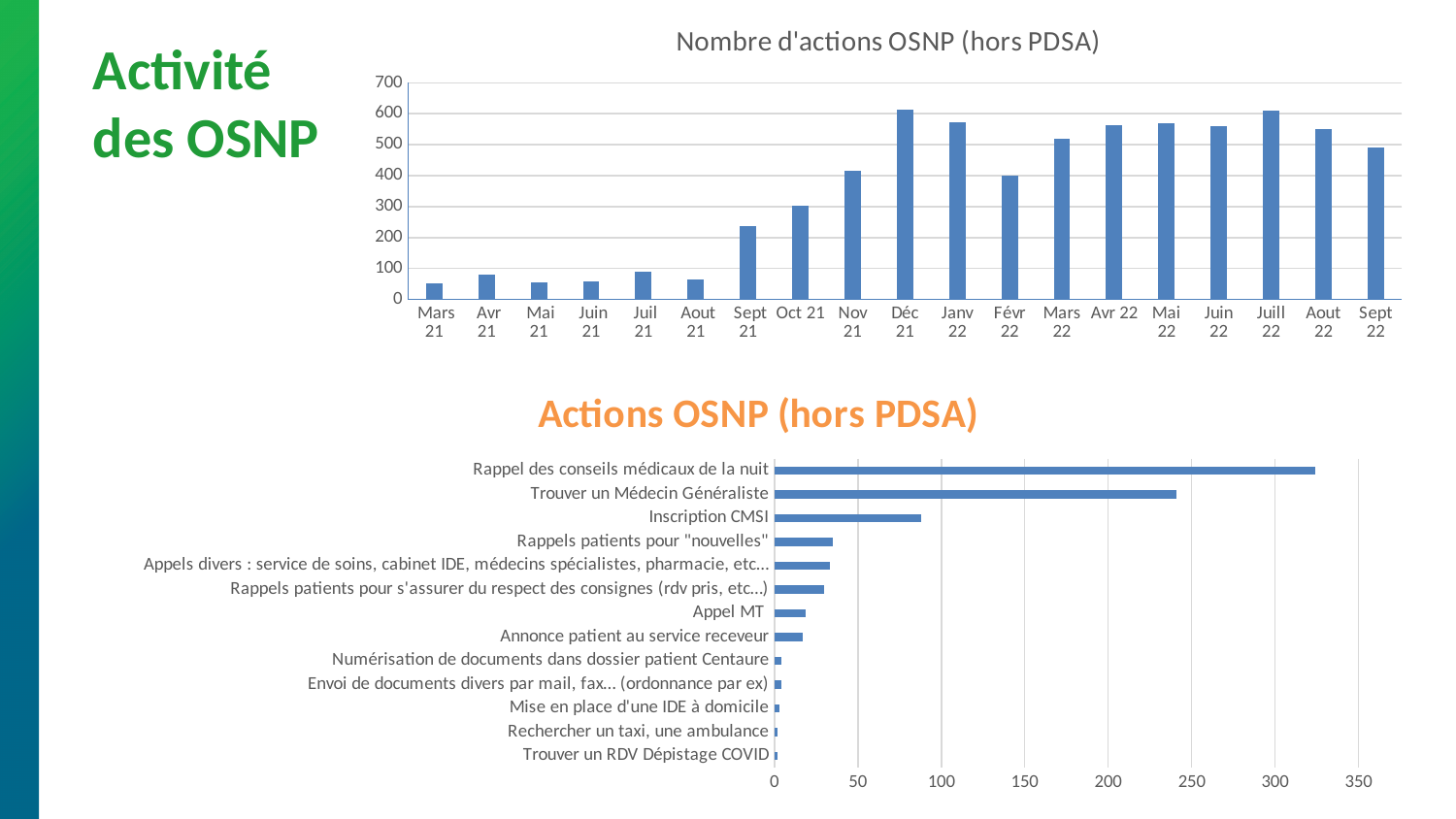
In the bottom chart "Actions OSNP (hors PDSA)", is the value for "Inscription CMSI" greater or less than 100? less In the top chart "Nombre d'actions OSNP (hors PDSA)", is the value for Mars 21 greater or less than 100? less How many months are shown on the x axis of the top chart "Nombre d'actions OSNP (hors PDSA)"? 19 What kind of chart is the bottom chart titled "Actions OSNP (hors PDSA)"? bar chart In the top chart "Nombre d'actions OSNP (hors PDSA)", is the value for Déc 21 greater or less than 600? greater In the top chart "Nombre d'actions OSNP (hors PDSA)", which is larger, the value for Oct 21 or the value for Nov 21? Nov 21 What kind of chart is the top chart titled "Nombre d'actions OSNP (hors PDSA)"? bar chart In the bottom chart "Actions OSNP (hors PDSA)", which category has the highest value? Rappel des conseils médicaux de la nuit How many categories are listed in the bottom chart "Actions OSNP (hors PDSA)"? 13 In the top chart "Nombre d'actions OSNP (hors PDSA)", do the values rise or fall from Mars 21 to Déc 21? rise